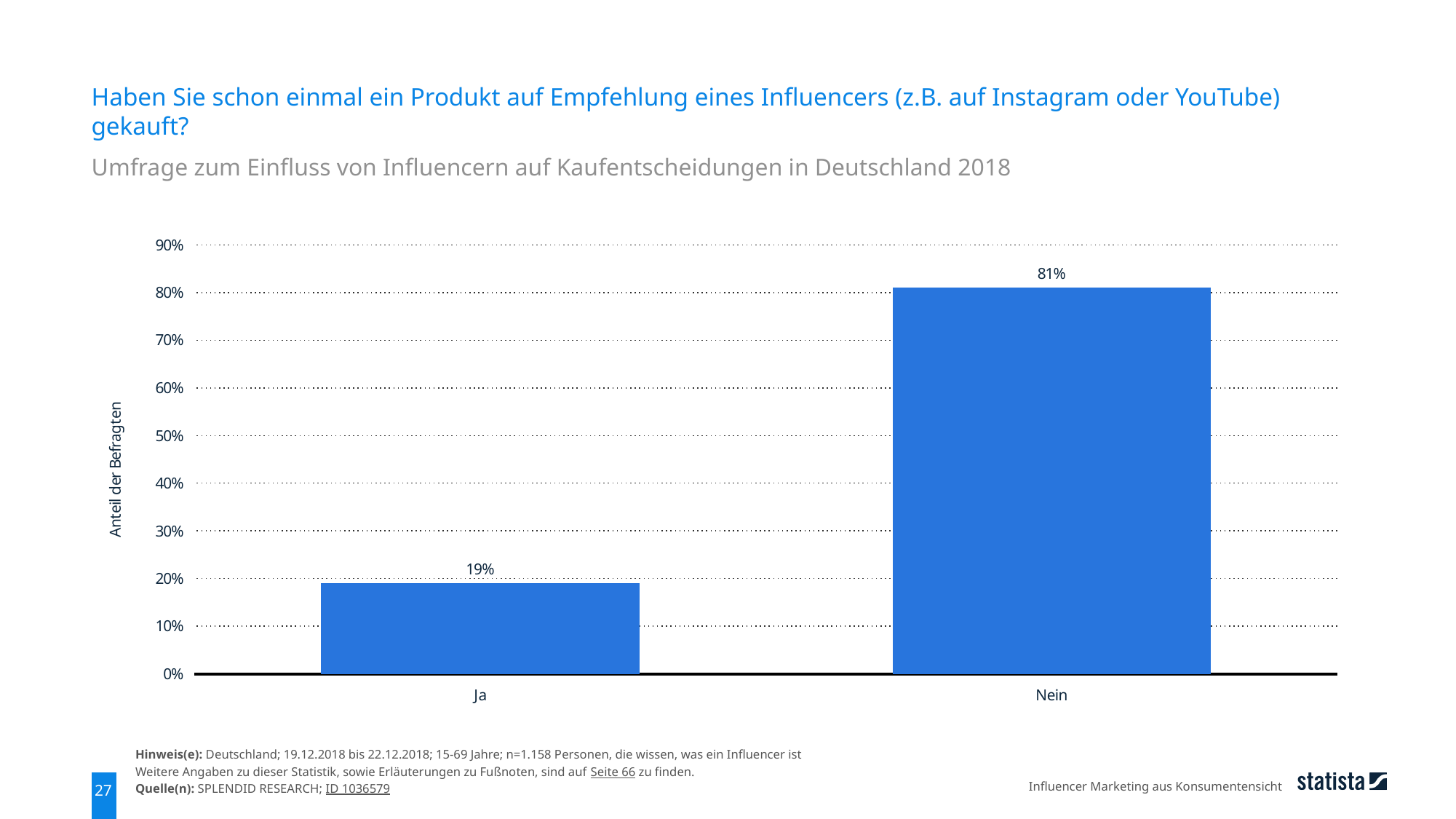
Is the value for "Ja" greater or less than 20%? less What kind of chart is shown on the slide? bar chart What is the label of the y axis? Anteil der Befragten Which is larger, the value for "Ja" or the value for "Nein"? Nein What is the difference between the values for "Nein" and "Ja"? 62% Which category has the highest value? Nein What is the highest tick value shown on the y axis? 90% What is the value for "Ja"? 19% How many categories are shown on the x axis? 2 Is the value for "Nein" greater or less than 80%? greater Which category has the lowest value? Ja What is the value for "Nein"? 81%